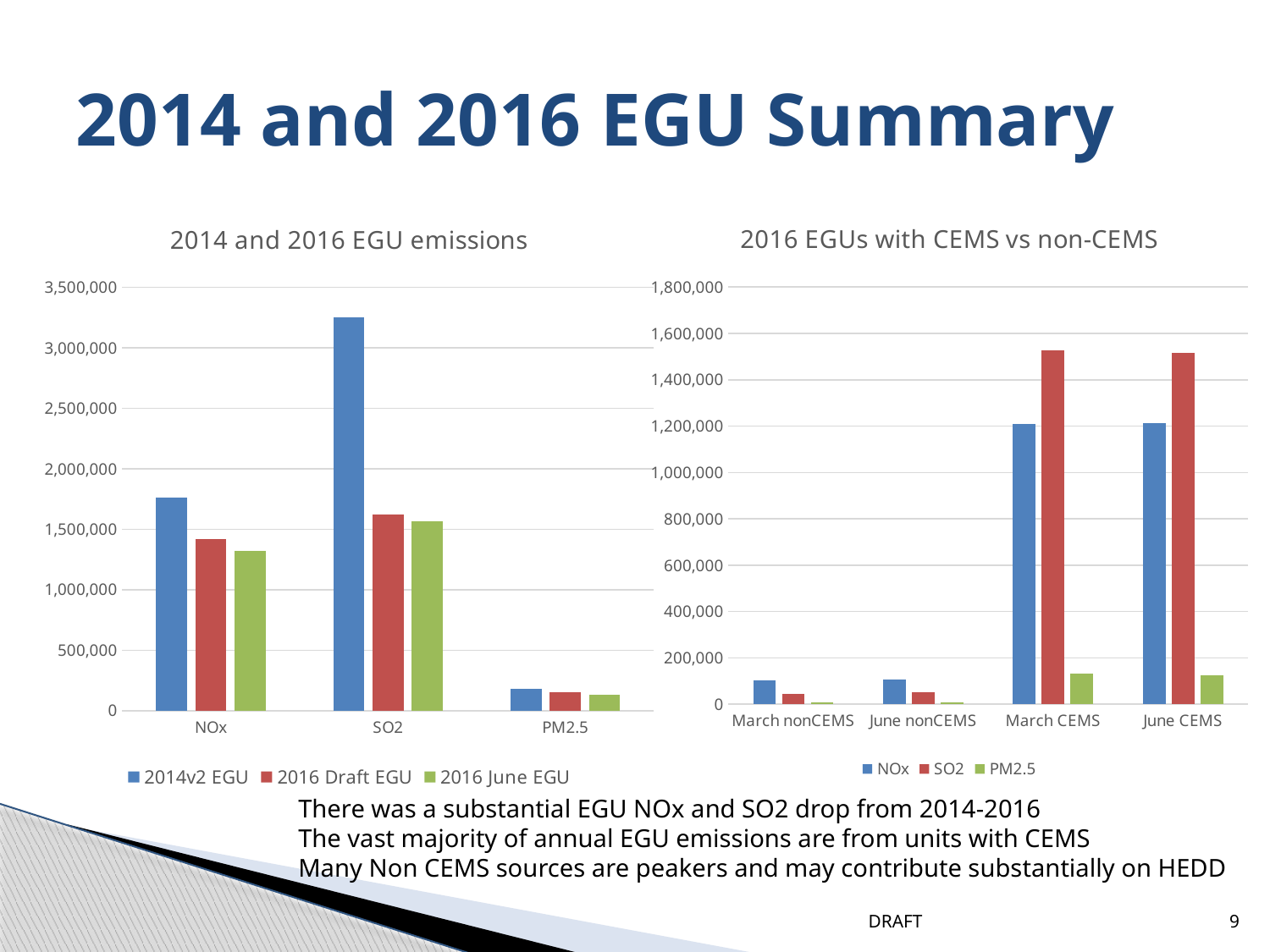
In the right chart "2016 EGUs with CEMS vs non-CEMS", is the NOx value for June CEMS greater or less than 1,000,000? greater In the left chart "2014 and 2016 EGU emissions", is the 2016 Draft EGU value for NOx greater or less than 1,500,000? less In the left chart "2014 and 2016 EGU emissions", how many series does the legend list? 3 In the right chart "2016 EGUs with CEMS vs non-CEMS", is the SO2 value for March CEMS greater or less than 1,400,000? greater In the left chart "2014 and 2016 EGU emissions", how many pollutant categories are shown on the x axis? 3 In the right chart "2016 EGUs with CEMS vs non-CEMS", which series has the highest value for March CEMS? SO2 In the right chart "2016 EGUs with CEMS vs non-CEMS", how many series does the legend list? 3 In the left chart "2014 and 2016 EGU emissions", which is larger for NOx: 2014v2 EGU or 2016 June EGU? 2014v2 EGU In the left chart "2014 and 2016 EGU emissions", which category has the highest 2014v2 EGU value? SO2 What kind of chart is the left chart titled "2014 and 2016 EGU emissions"? bar chart In the right chart "2016 EGUs with CEMS vs non-CEMS", how many categories are shown on the x axis? 4